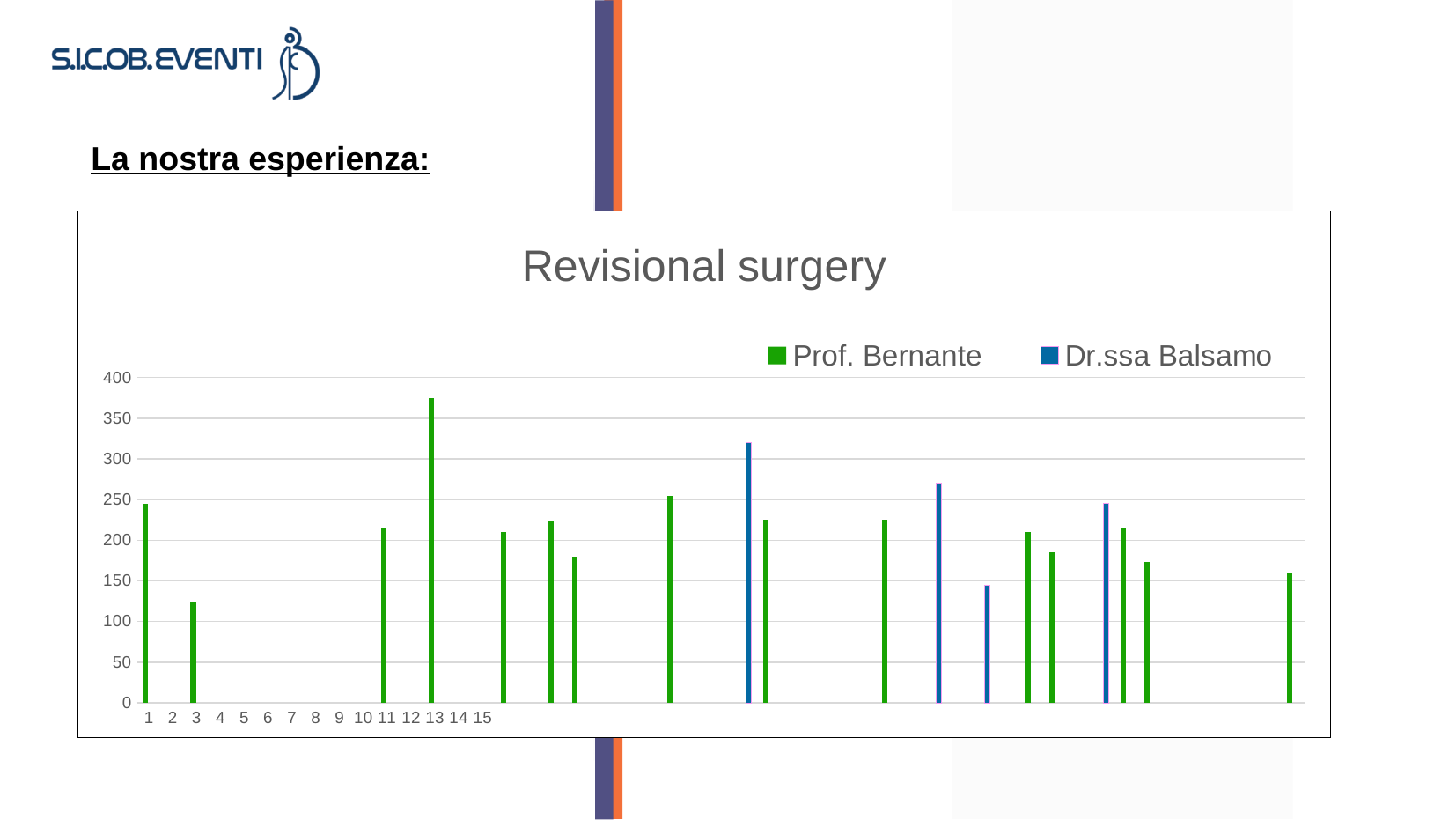
Which category has the highest bar in the chart? 13 Is the Prof. Bernante value for category 13 greater or less than 350? greater How many series does the legend list? 2 Is the Prof. Bernante value for category 3 greater or less than 150? less Is the Prof. Bernante value for category 11 greater or less than 250? less Which of categories 1 and 3 has the larger Prof. Bernante value? 1 What is the title of the chart? Revisional surgery What type of chart is shown on the slide? bar chart Among the labelled categories 1, 3, 11 and 13, which has the lowest Prof. Bernante value? 3 Which of categories 11 and 13 has the larger Prof. Bernante value? 13 Which series is shown in green in the legend? Prof. Bernante